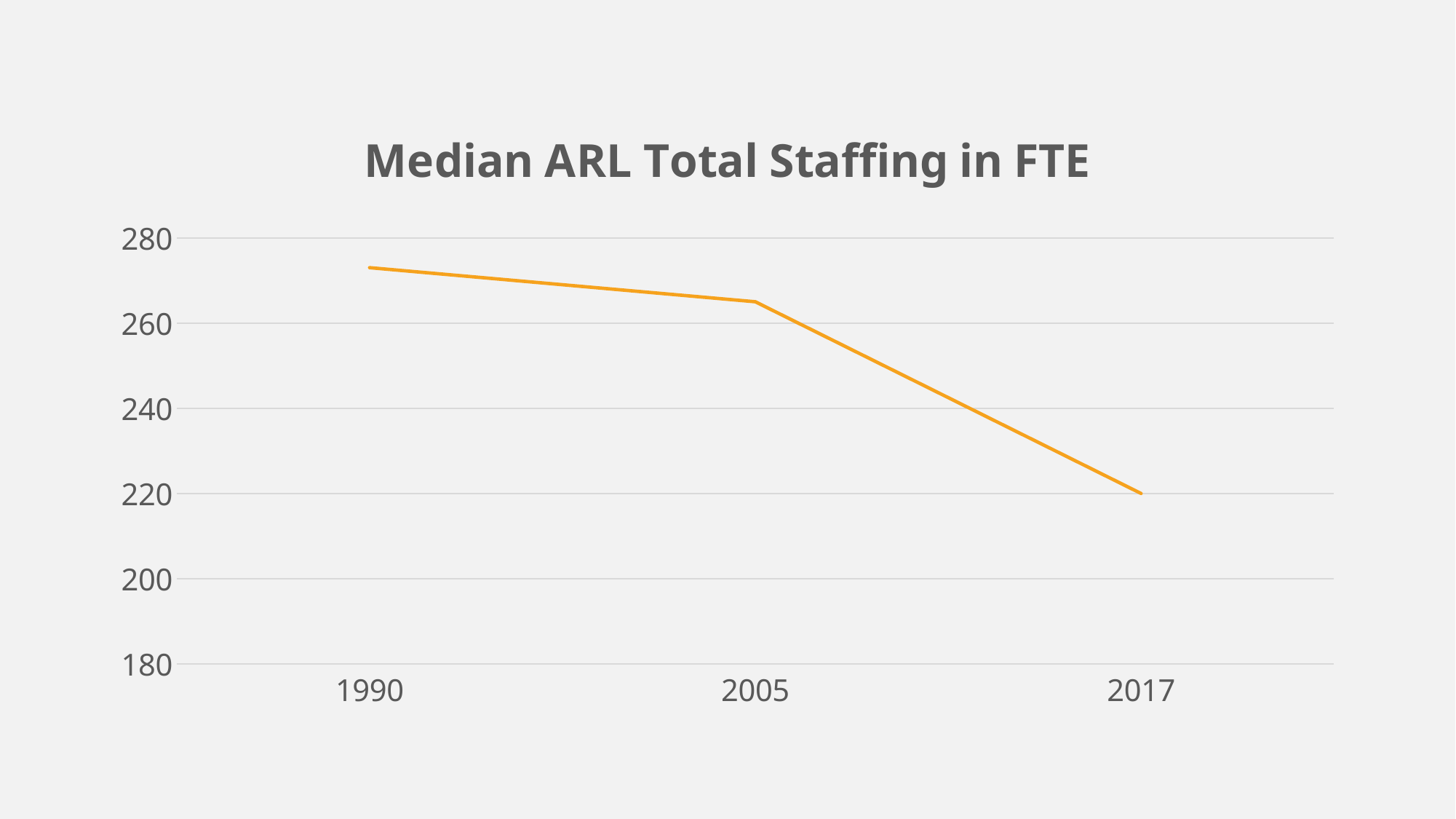
Is the value for 1990 greater or less than 280? less Is the value for 2017 greater or less than 240? less Which is larger, the value for 1990 or the value for 2005? 1990 How many years are plotted on the x axis? 3 Is the value for 2005 greater or less than 260? greater What kind of chart is shown on the slide? line chart Which year has the highest median ARL total staffing? 1990 Do the values rise or fall from 1990 to 2017? fall What is the title of the chart? Median ARL Total Staffing in FTE Which is larger, the value for 2005 or the value for 2017? 2005 Which year has the lowest median ARL total staffing? 2017